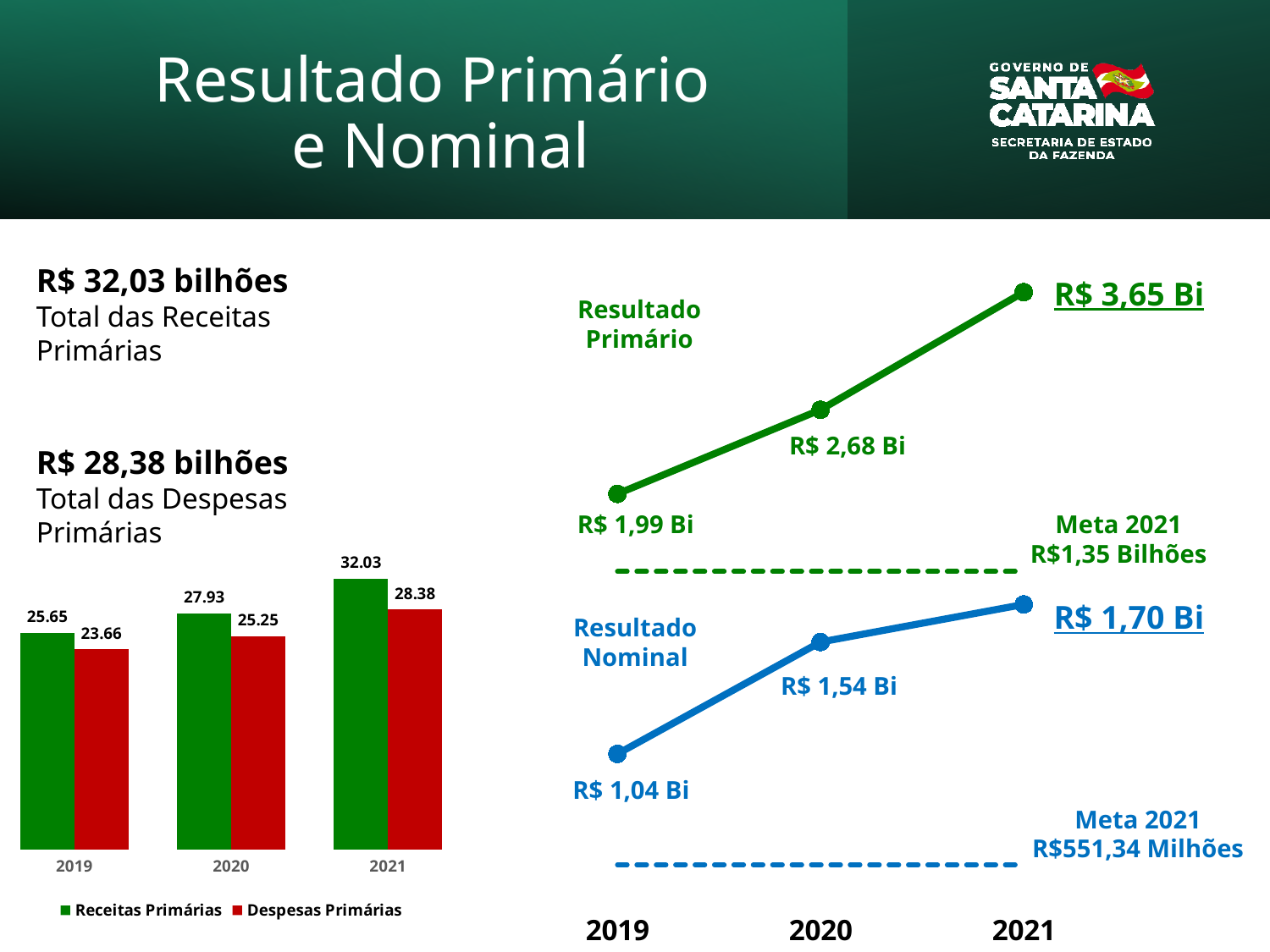
In the bar chart on the left, what is the value of Receitas Primárias for 2021? 32.03 In the bar chart on the left, what is the value of Despesas Primárias for 2019? 23.66 In the bar chart on the left, which year has the lowest Despesas Primárias? 2019 In the Resultado Nominal line chart on the right, which year has the highest value? 2021 In the line charts on the right, what is the Meta 2021 shown for Resultado Primário? R$1,35 Bilhões In the Resultado Nominal line chart on the right, what is the value for 2019? R$ 1,04 Bi In the bar chart on the left, what is the difference between Receitas Primárias and Despesas Primárias in 2020? 2.68 In the bar chart on the left, how many series does the legend list? 2 In the bar chart on the left, do Receitas Primárias rise or fall from 2019 to 2021? Rise In the Resultado Primário line chart on the right, what is the value for 2020? R$ 2,68 Bi In the bar chart on the left, which year has the highest Receitas Primárias? 2021 What kind of chart is shown on the left of the slide? Bar chart